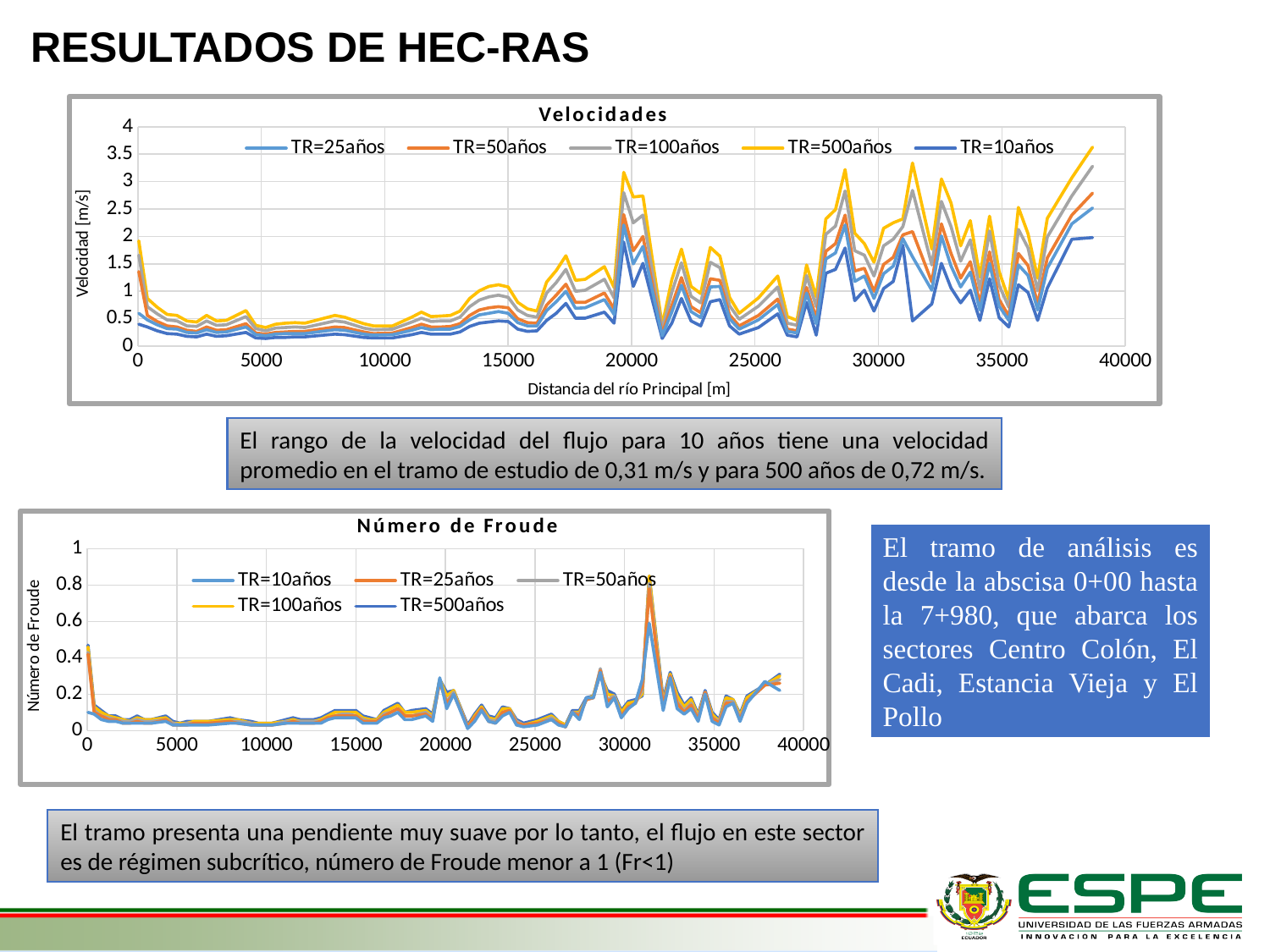
How many series does the legend of the "Velocidades" chart list? 5 In the "Velocidades" chart, which series has the lowest values along the river? TR=10años In the "Velocidades" chart, at a distance of 0 m, which is larger: TR=500años or TR=10años? TR=500años In the "Velocidades" chart, which series has the highest values along the river? TR=500años In the "Velocidades" chart, is the peak value of TR=500años near 38000 m greater or less than 3? greater How many series does the legend of the "Número de Froude" chart list? 5 What kind of chart is the "Velocidades" chart? line chart In the "Número de Froude" chart, is the highest peak (near 31000 m) greater or less than 0.6? greater In the "Velocidades" chart, is the value of TR=10años at 5000 m greater or less than 0.5? less In the "Velocidades" chart, what is the title of the horizontal axis? Distancia del río Principal [m] What kind of chart is the "Número de Froude" chart? line chart In the "Velocidades" chart, what is the title of the vertical axis? Velocidad [m/s]